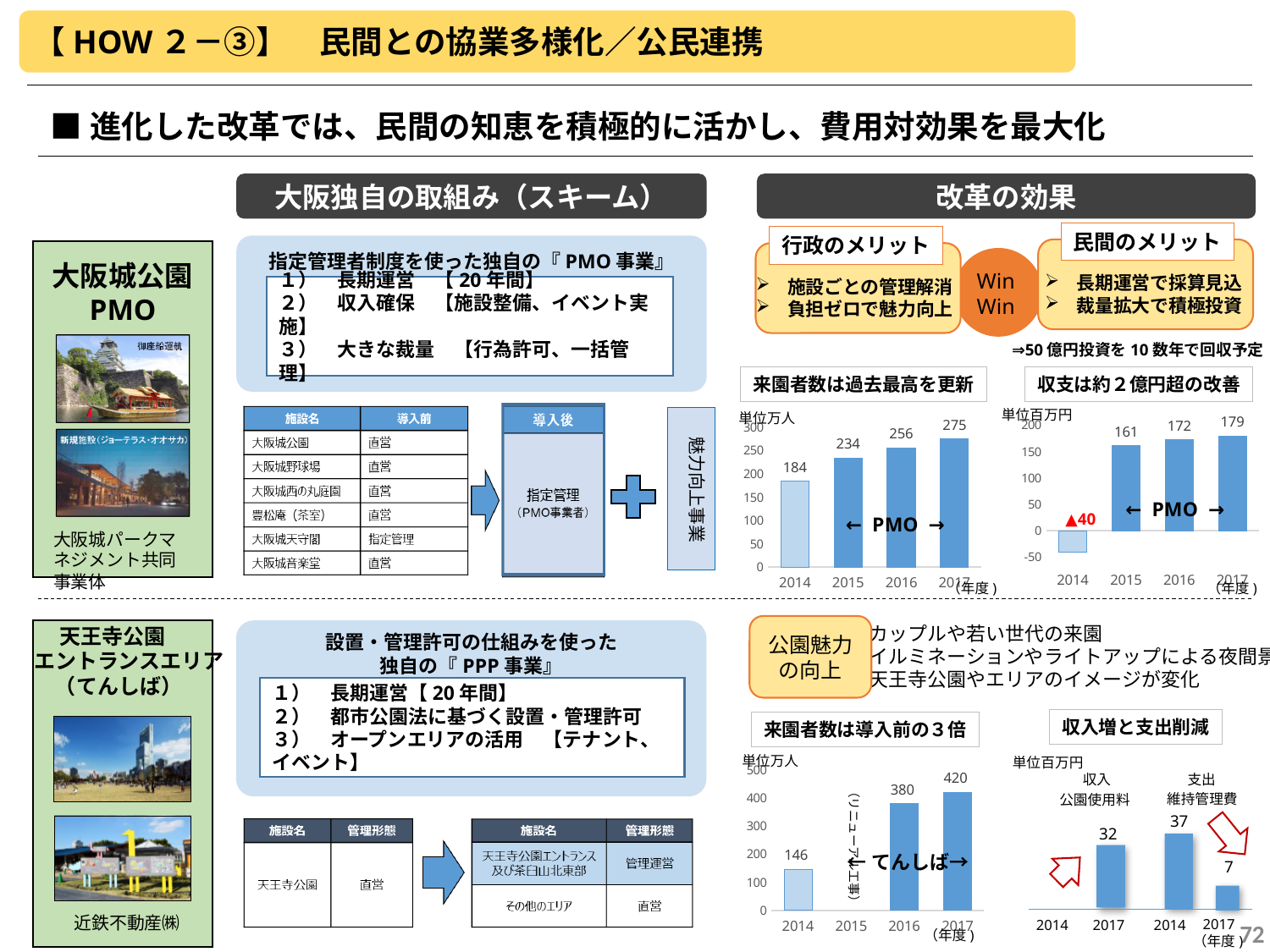
In the chart titled 収支は約２億円超の改善, which year has the highest value? 2017 In the chart titled 収支は約２億円超の改善, what is the value for 2016? 172 In the chart titled 収支は約２億円超の改善, what is the value for 2014? ▲40 In the chart titled 来園者数は過去最高を更新, do the values rise or fall from 2014 to 2017? rise What kind of chart is the chart titled 来園者数は過去最高を更新? bar chart In the chart titled 来園者数は導入前の３倍, what is the difference between the 2017 and 2014 values? 274 In the chart titled 来園者数は導入前の３倍, what is the value for 2016? 380 In the chart titled 来園者数は過去最高を更新, what is the value for 2014? 184 In the chart titled 来園者数は過去最高を更新, what is the value for 2017? 275 In the chart titled 収入増と支出削減, what is the 2017 value for 支出 維持管理費? 7 In the chart titled 収入増と支出削減, which is larger: the 2014 value for 支出 維持管理費 or the 2017 value for 収入 公園使用料? 2014 支出 維持管理費 In the chart titled 来園者数は過去最高を更新, what is the difference between the 2017 and 2014 values? 91